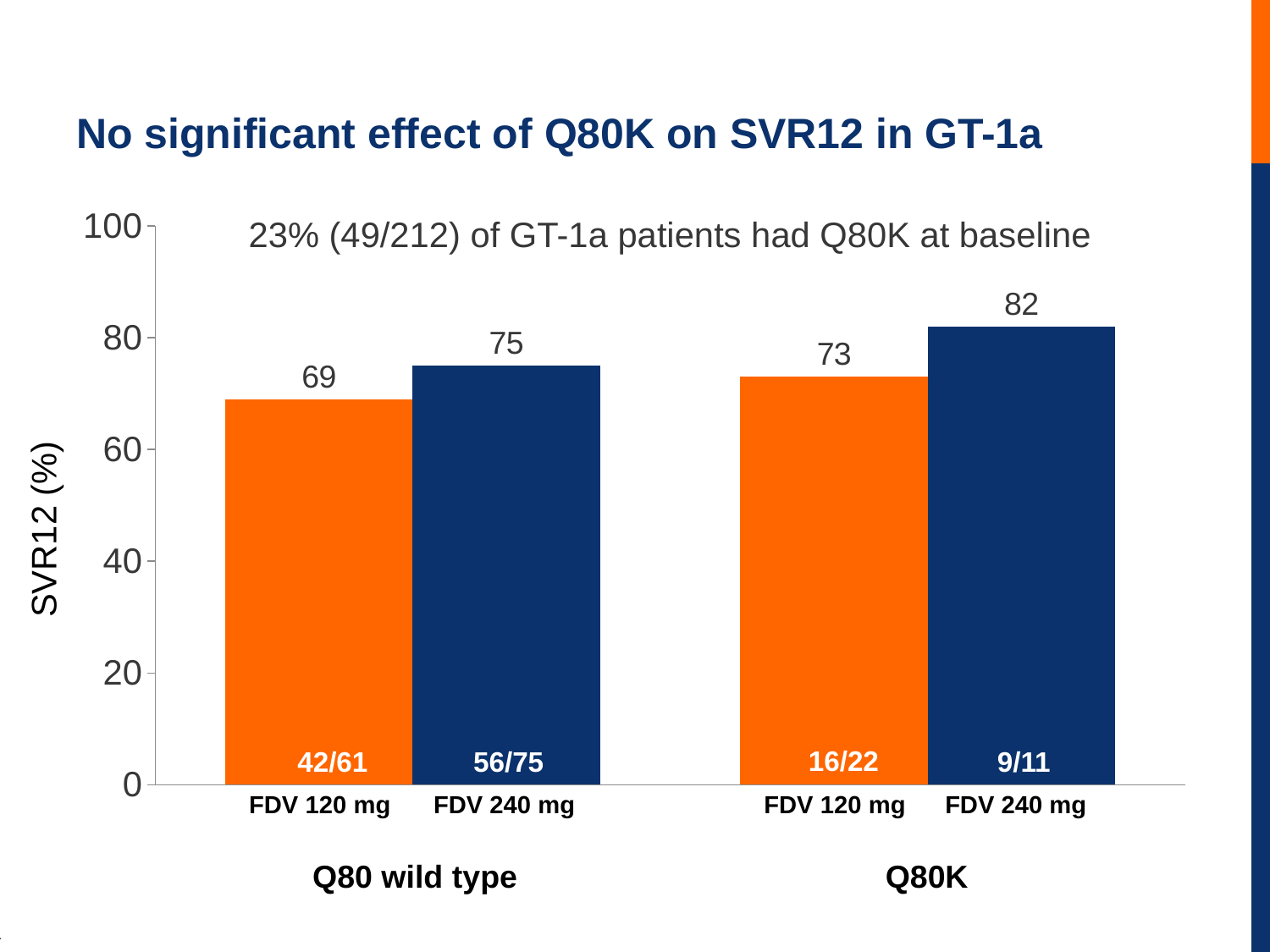
Which bar has the lowest SVR12 (%)? FDV 120 mg, Q80 wild type How many bars are plotted in the chart? 4 Is the SVR12 (%) for FDV 240 mg in the Q80K group greater or less than 80? greater What is the SVR12 (%) for FDV 240 mg in the Q80K group? 82 Which has a higher SVR12 (%): FDV 240 mg in the Q80 wild type group or FDV 120 mg in the Q80K group? FDV 240 mg in the Q80 wild type group What is the difference in SVR12 (%) between FDV 240 mg and FDV 120 mg in the Q80K group? 9 What kind of chart is shown on the slide? bar chart Which bar has the highest SVR12 (%)? FDV 240 mg, Q80K What is the label of the y axis? SVR12 (%) What is the SVR12 (%) for FDV 120 mg in the Q80K group? 73 What is the SVR12 (%) for FDV 120 mg in the Q80 wild type group? 69 What fraction of patients is shown inside the FDV 240 mg bar in the Q80 wild type group? 56/75